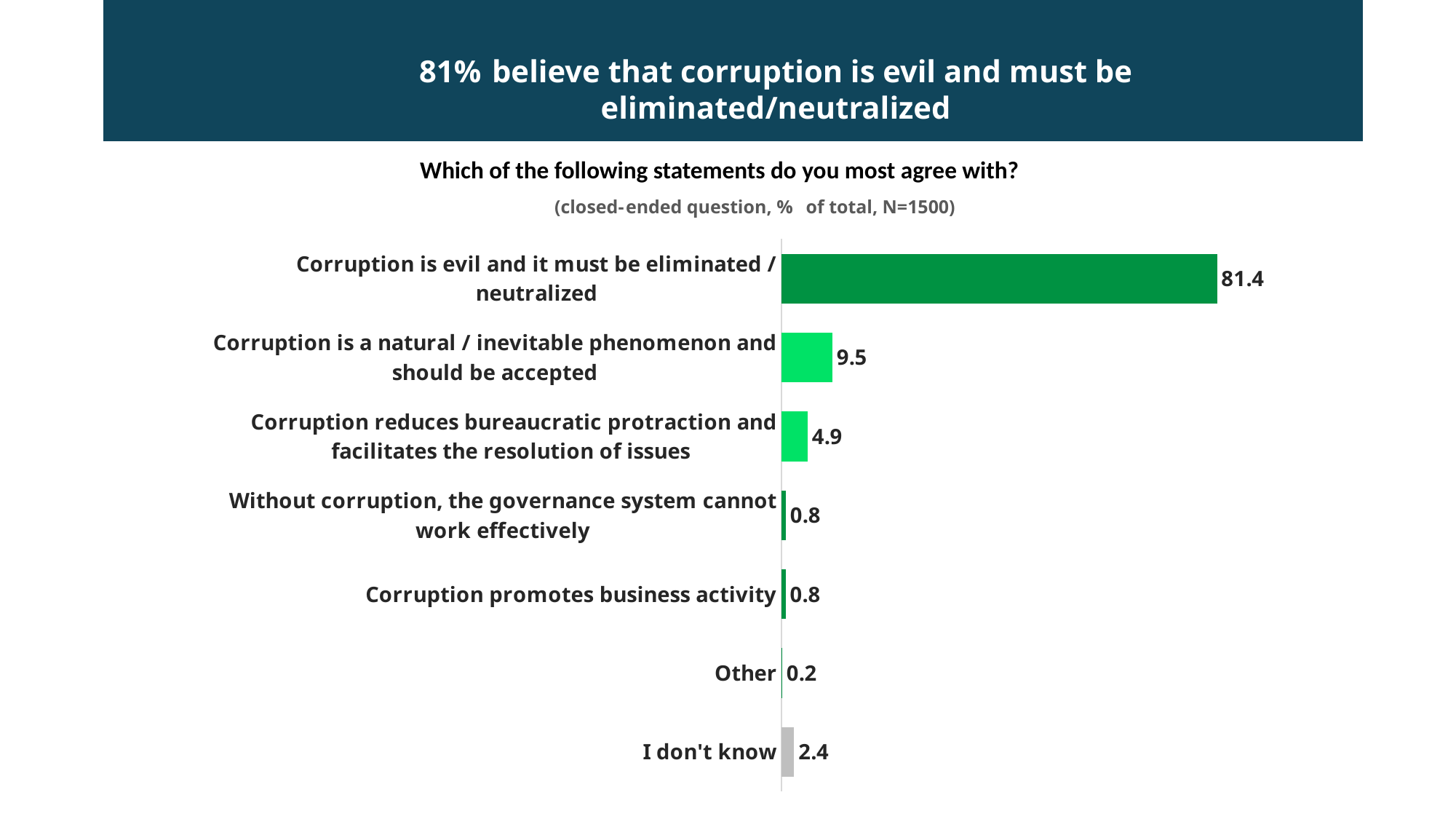
What percentage of respondents agree that corruption is evil and it must be eliminated / neutralized? 81.4 What is the sample size (N) stated in the chart subtitle? N=1500 Which is larger: the value for 'Corruption reduces bureaucratic protraction and facilitates the resolution of issues' or the value for 'I don't know'? Corruption reduces bureaucratic protraction and facilitates the resolution of issues Which statement has the highest share of respondents? Corruption is evil and it must be eliminated / neutralized What value is shown for 'I don't know'? 2.4 What value is shown for 'Other'? 0.2 What value is shown for 'Corruption is a natural / inevitable phenomenon and should be accepted'? 9.5 What value is shown for 'Corruption reduces bureaucratic protraction and facilitates the resolution of issues'? 4.9 Which category has the lowest value? Other How many categories are shown in the chart? 7 What kind of chart is shown on the slide? Bar chart What is the difference between the values for 'Corruption is evil and it must be eliminated / neutralized' and 'Corruption is a natural / inevitable phenomenon and should be accepted'? 71.9